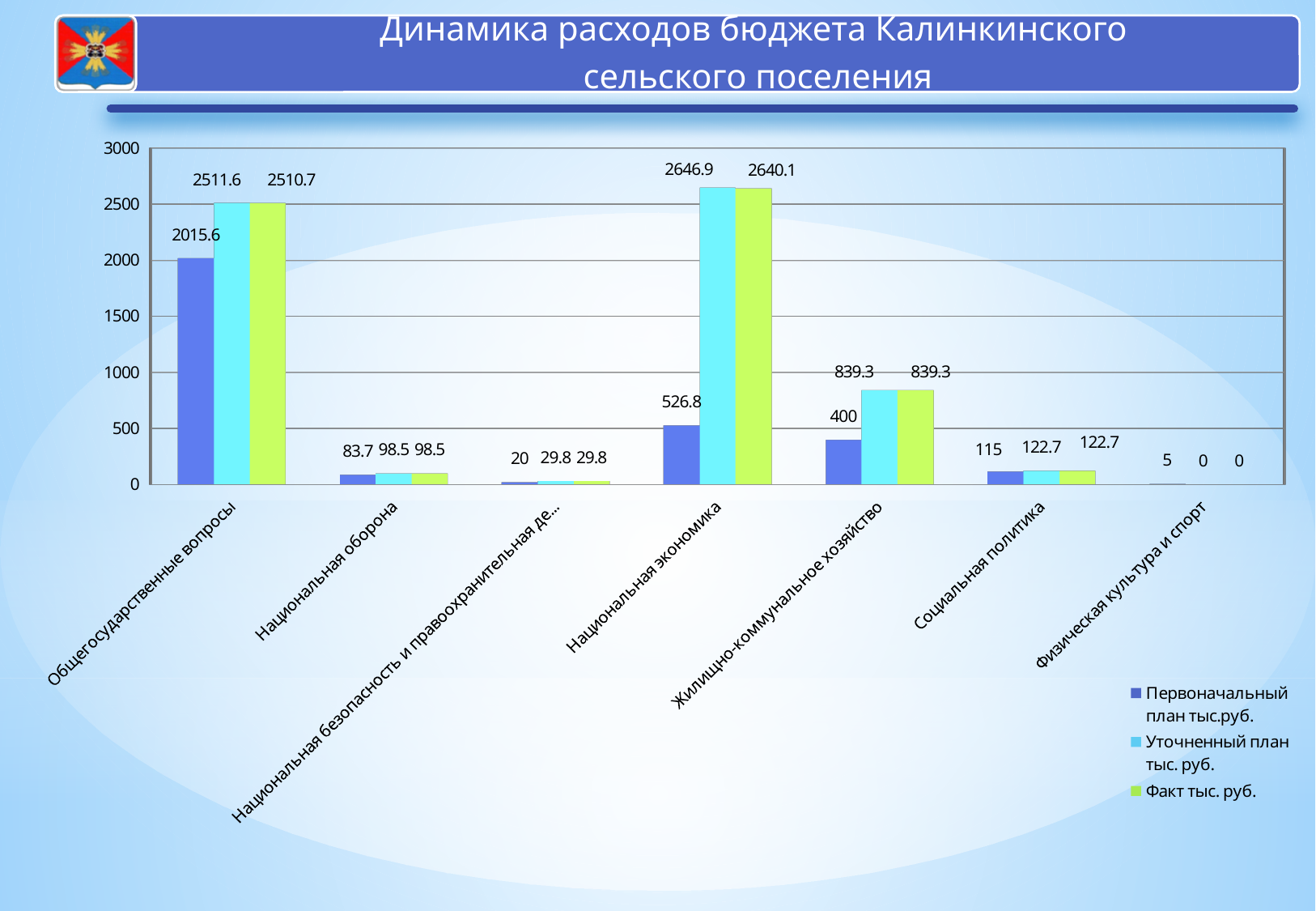
How many series does the legend list? 3 Is the value of Первоначальный план тыс.руб. for Жилищно-коммунальное хозяйство greater or less than 500? less What is the value of Первоначальный план тыс.руб. for Общегосударственные вопросы? 2015.6 Which category has the highest value for Уточненный план тыс. руб.? Национальная экономика What is the value of Уточненный план тыс. руб. for Жилищно-коммунальное хозяйство? 839.3 What is the value of Факт тыс. руб. for Национальная экономика? 2640.1 How many categories are shown on the x axis? 7 Which is larger for Социальная политика: Первоначальный план тыс.руб. or Факт тыс. руб.? Факт тыс. руб. What is the difference between Уточненный план тыс. руб. and Первоначальный план тыс.руб. for Национальная экономика? 2120.1 What kind of chart is shown on the slide? Bar chart What is the value of Первоначальный план тыс.руб. for Физическая культура и спорт? 5 Which category has the lowest value for Факт тыс. руб.? Физическая культура и спорт